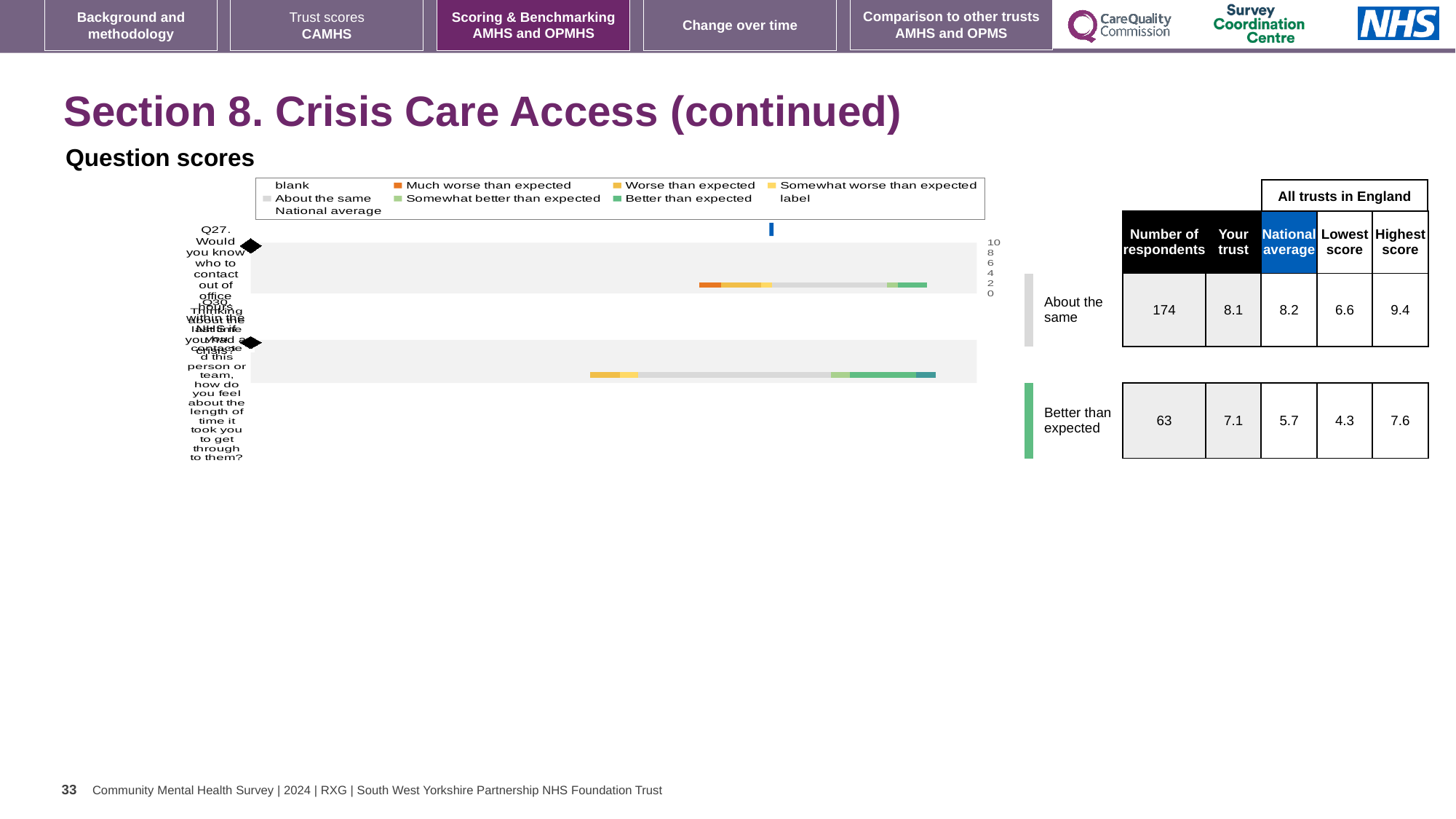
According to the table beside the chart, what is the national average for Q30 (Better than expected)? 5.7 According to the table beside the chart, how many respondents answered Q27? 174 What is the lowest score across all trusts in England for Q30 in the table? 4.3 According to the table beside the chart, how many respondents answered Q30? 63 In the chart legend, what colour represents 'Much worse than expected'? orange What is the highest score across all trusts in England for Q27 in the table? 9.4 What is the highest tick value shown on the chart's axis? 10 According to the table beside the chart, what is the 'Your trust' score for Q27 (About the same)? 8.1 How many questions (bars) are plotted in the chart? 2 What is the difference between the 'Your trust' score and the national average for Q30 in the table? 1.4 Which question has the higher 'Your trust' score in the table, Q27 or Q30? Q27 What kind of chart is shown under 'Question scores'? bar chart